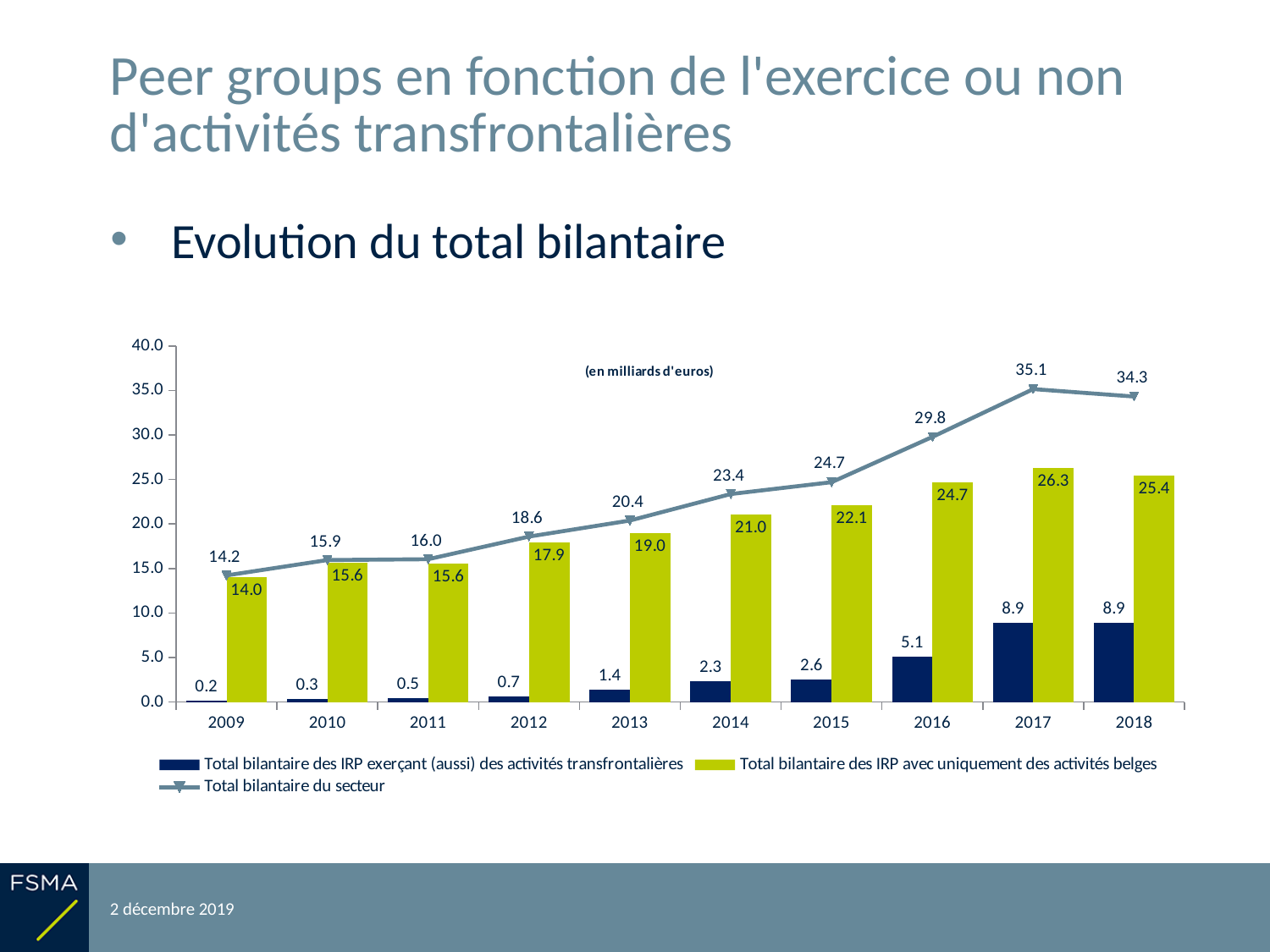
What is the value of 'Total bilantaire du secteur' in 2017? 35.1 Which is larger: 'Total bilantaire des IRP avec uniquement des activités belges' in 2018 or in 2017? 2017 In which year is 'Total bilantaire des IRP avec uniquement des activités belges' highest? 2017 What unit is indicated on the chart? en milliards d'euros What kind of chart is shown on the slide? Combined bar and line chart How many years are shown on the x axis? 10 What is the value of 'Total bilantaire des IRP avec uniquement des activités belges' in 2014? 21.0 Does 'Total bilantaire des IRP exerçant (aussi) des activités transfrontalières' generally rise or fall from 2009 to 2018? Rise What is the difference between 'Total bilantaire du secteur' in 2018 and in 2009? 20.1 In which year is 'Total bilantaire du secteur' lowest? 2009 What is the value of 'Total bilantaire des IRP exerçant (aussi) des activités transfrontalières' in 2016? 5.1 How many series does the legend list? 3